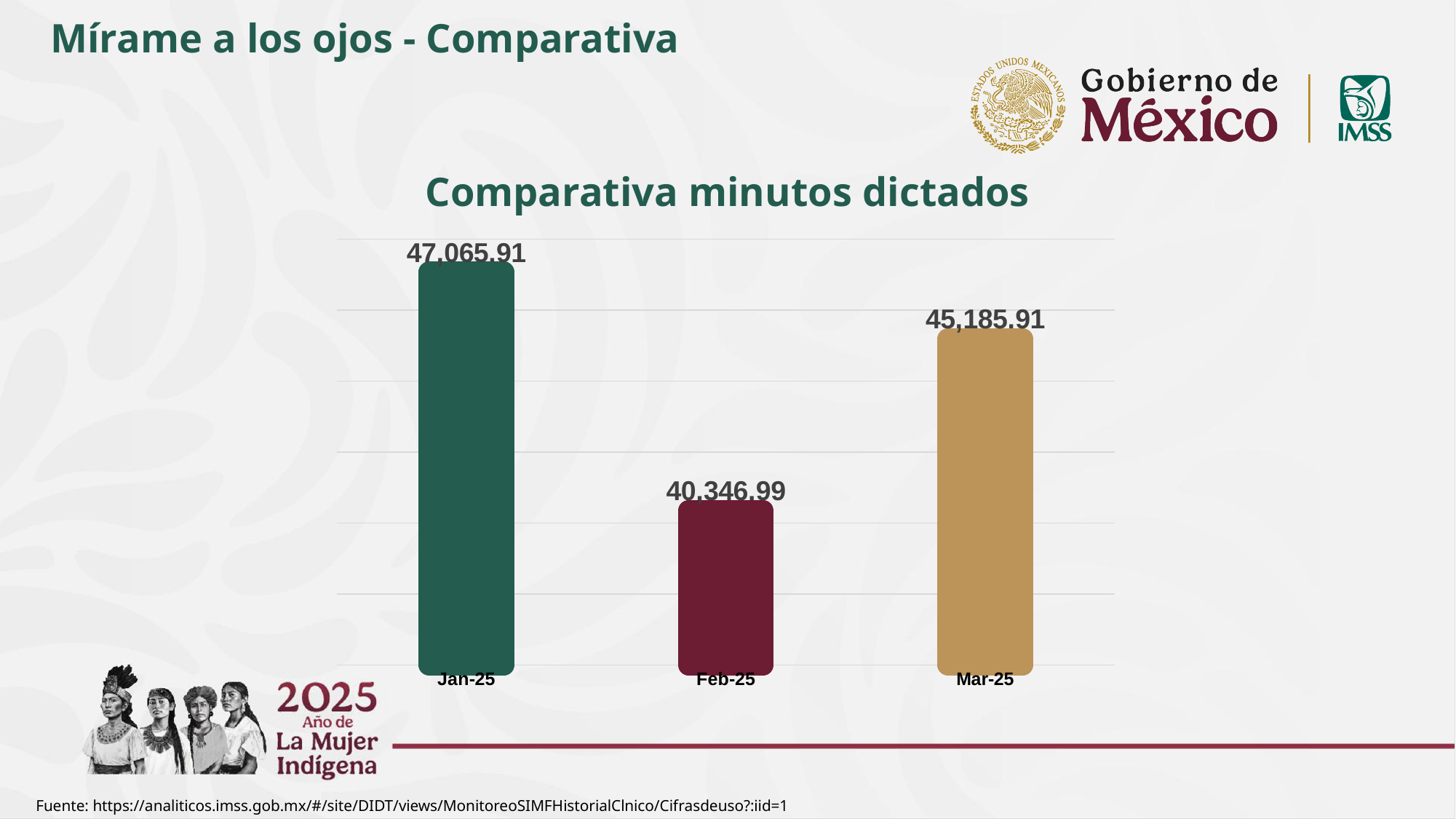
Which month has the lowest value in the chart? Feb-25 What is the difference between the values for Mar-25 and Feb-25? 4,838.92 Which is larger, the value for Feb-25 or the value for Mar-25? Mar-25 What is the value for Jan-25 in the chart? 47,065.91 What kind of chart is shown on the slide? Bar chart What is the value for Feb-25 in the chart? 40,346.99 How many months are shown in the chart? 3 What is the title of the chart? Comparativa minutos dictados What is the difference between the values for Jan-25 and Mar-25? 1,880.00 Which month has the highest value in the chart? Jan-25 What is the value for Mar-25 in the chart? 45,185.91 What is the difference between the values for Jan-25 and Feb-25? 6,718.92